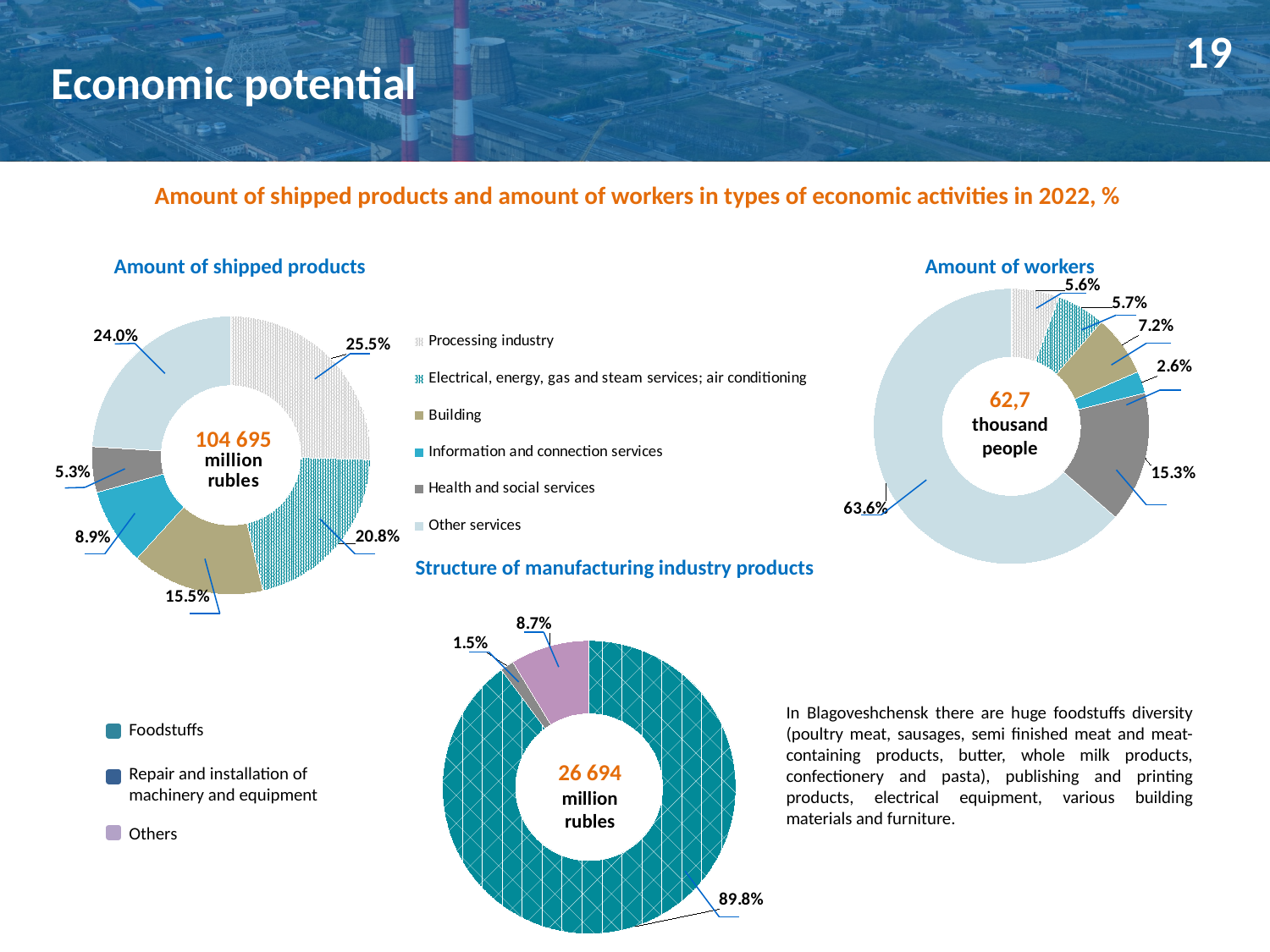
In the 'Amount of shipped products' chart, what share does the Processing industry have? 25.5% In the 'Amount of shipped products' chart, what share does Building have? 15.5% In the 'Structure of manufacturing industry products' chart, what share do Foodstuffs have? 89.8% In the 'Amount of workers' chart, which is larger: the share for Building or the share for Information and connection services? Building In the 'Amount of shipped products' chart, what is the difference between the Processing industry share and the Building share? 10.0% In the 'Amount of workers' chart, which category has the largest share? Other services How many categories does the 'Structure of manufacturing industry products' chart show? 3 In the 'Amount of workers' chart, what share do Other services have? 63.6% What type of chart is the 'Amount of workers' chart? Donut (pie) chart In the 'Amount of shipped products' chart, which category has the smallest share? Health and social services What total value is shown in the centre of the 'Structure of manufacturing industry products' chart? 26 694 million rubles In the 'Amount of workers' chart, what share do Health and social services have? 15.3%